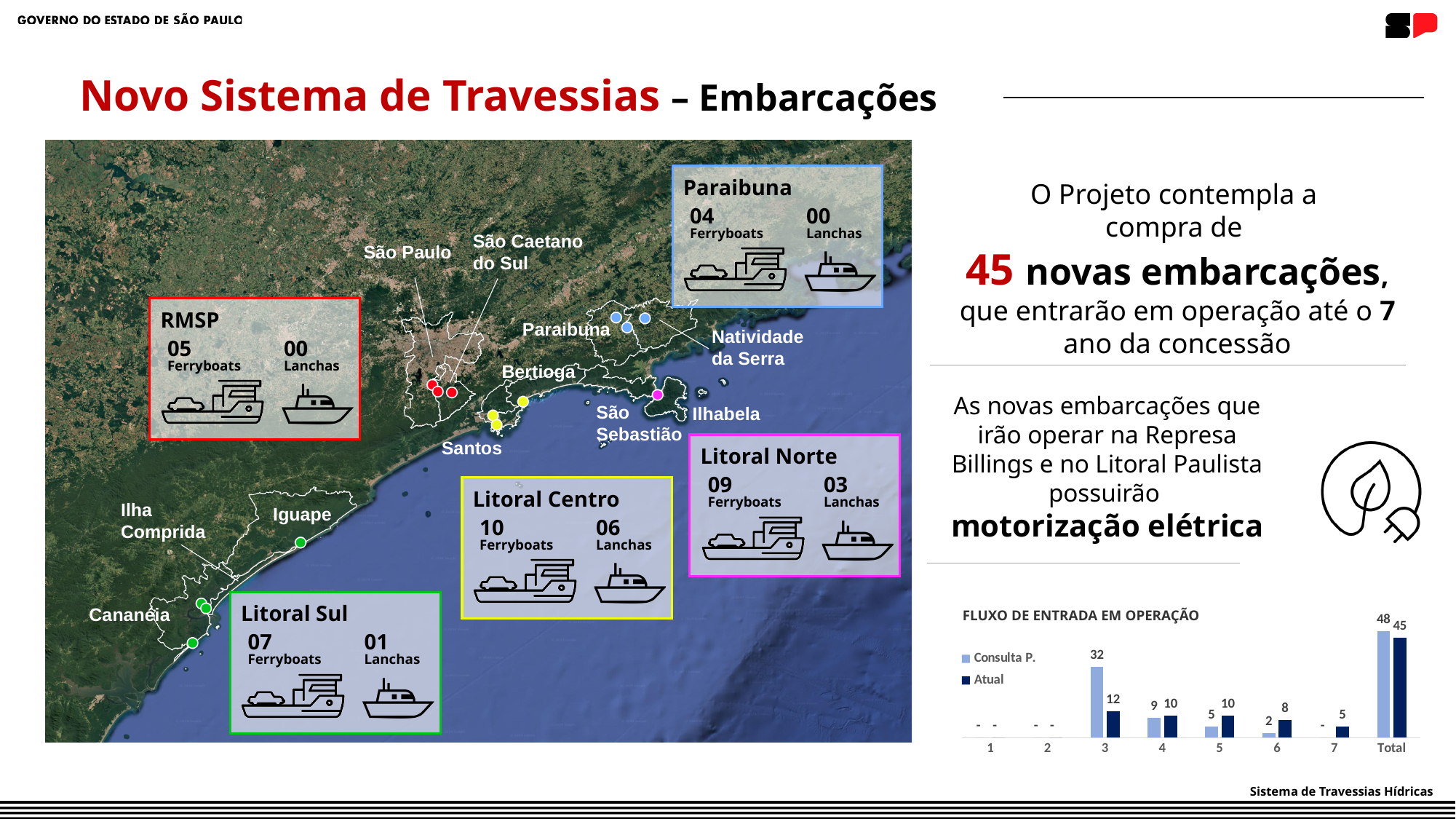
What is the difference between the Consulta P. and Atual values for category 3? 20 What kind of chart is shown on the slide? bar chart Which is larger for category 5, the Consulta P. value or the Atual value? Atual Excluding Total, which category has the highest Consulta P. value? 3 What is the Atual value for category 7? 5 What is the Atual value for Total? 45 What is the Atual value for category 6? 8 How many series does the chart's legend list? 2 What is the title of the chart on the slide? FLUXO DE ENTRADA EM OPERAÇÃO What is the Consulta P. value for Total? 48 What is the Consulta P. value for category 3? 32 How many categories are shown on the x axis of the chart? 8